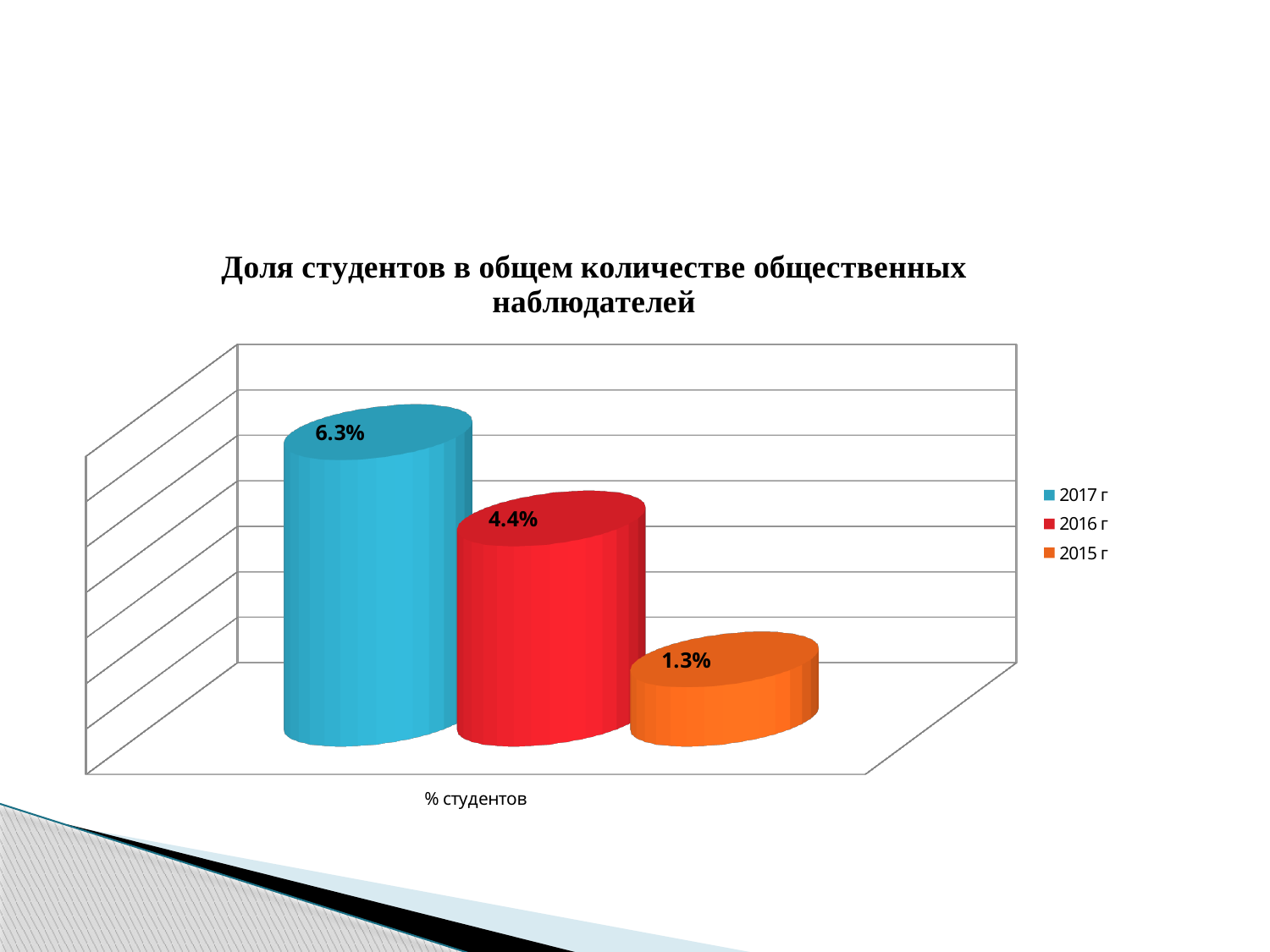
What is the title of the chart? Доля студентов в общем количестве общественных наблюдателей How many series does the legend list? 3 What is the difference between the values for 2017 г and 2016 г? 1.9% What is the value for 2015 г? 1.3% What is the difference between the values for 2016 г and 2015 г? 3.1% What kind of chart is shown on the slide? Bar chart Which year has the lowest share of students? 2015 г What is the value for 2016 г? 4.4% Which year has the highest share of students? 2017 г Which is larger, the value for 2016 г or the value for 2015 г? 2016 г What is the value for 2017 г? 6.3% What is the difference between the values for 2017 г and 2015 г? 5.0%